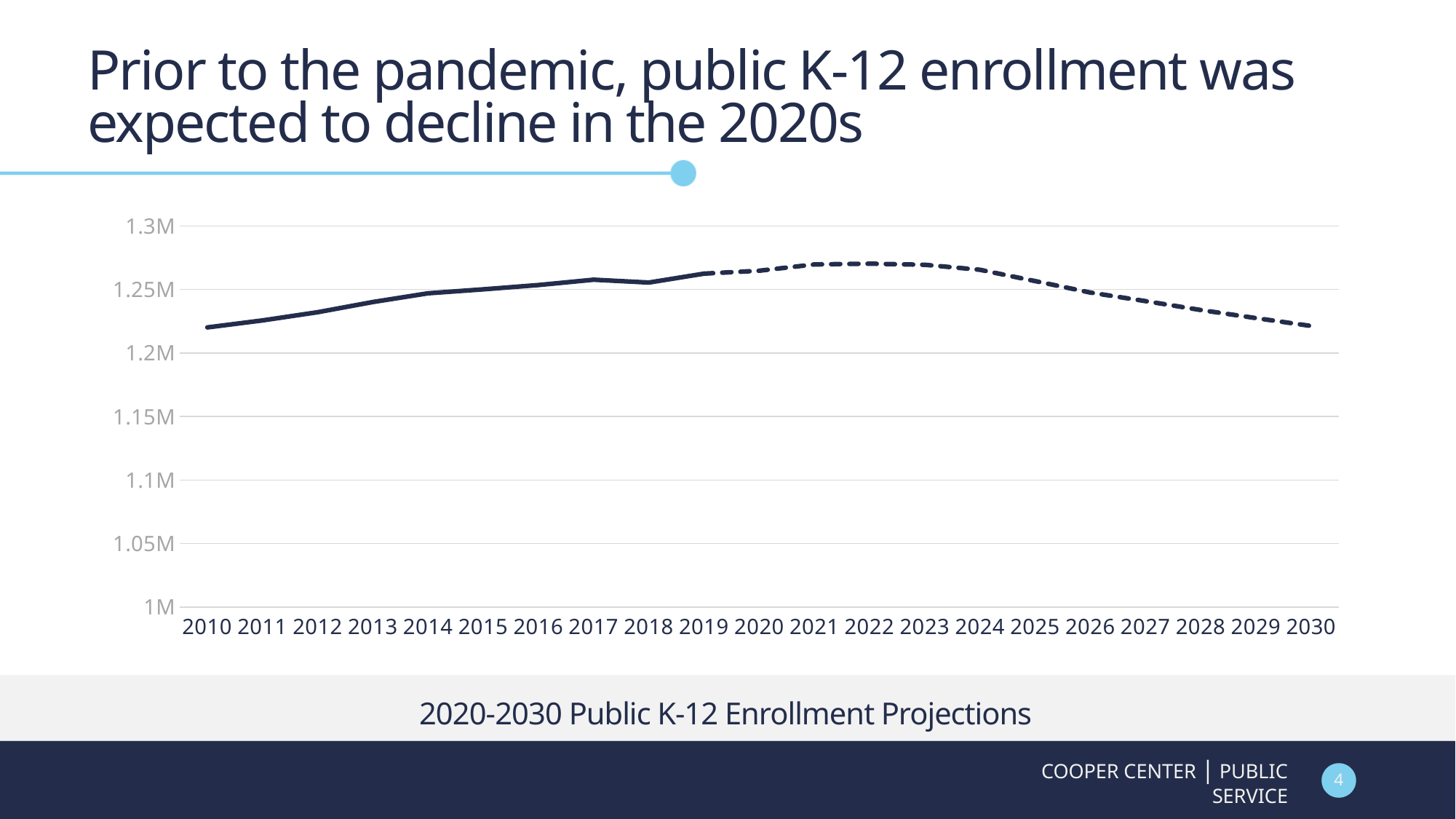
Is the value for 2010 greater or less than 1.2M? greater Which is larger, the value for 2012 or the value for 2020? 2020 Is the value for 2021 greater or less than 1.3M? less Which is larger, the value for 2010 or the value for 2022? 2022 Do the values rise or fall from 2010 to 2019? rise How many years are shown on the x axis of the chart? 21 Is the value for 2030 greater or less than 1.25M? less Do the values rise or fall from 2023 to 2030? fall What kind of chart is shown on the slide? line chart What is the title shown beneath the chart? 2020-2030 Public K-12 Enrollment Projections